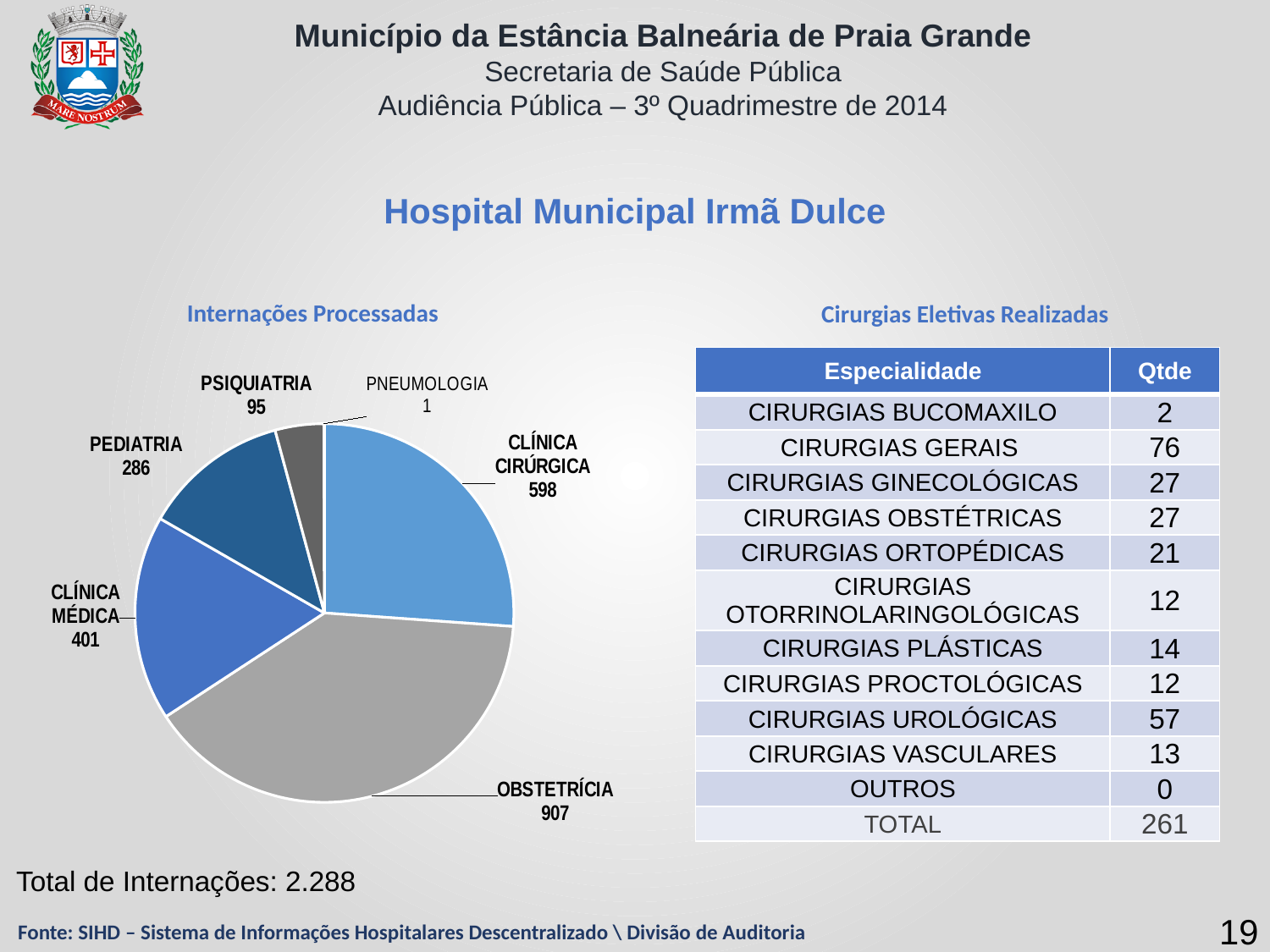
In the "Internações Processadas" pie chart, what is the value for CLÍNICA CIRÚRGICA? 598 Which category has the largest slice in the "Internações Processadas" pie chart? OBSTETRÍCIA Which category has the smallest slice in the "Internações Processadas" pie chart? PNEUMOLOGIA What is the total of all slices in the "Internações Processadas" pie chart, as stated on the slide? 2.288 In the "Internações Processadas" pie chart, which is larger: CLÍNICA MÉDICA or PSIQUIATRIA? CLÍNICA MÉDICA What type of chart is shown under the title "Internações Processadas"? pie chart In the "Internações Processadas" pie chart, what is the difference between CLÍNICA MÉDICA and PEDIATRIA? 115 In the "Internações Processadas" pie chart, what is the value for OBSTETRÍCIA? 907 How many categories are shown in the "Internações Processadas" pie chart? 6 In the "Internações Processadas" pie chart, what is the difference between OBSTETRÍCIA and CLÍNICA CIRÚRGICA? 309 In the "Internações Processadas" pie chart, what is the value for PEDIATRIA? 286 In the "Internações Processadas" pie chart, what is the value for PNEUMOLOGIA? 1